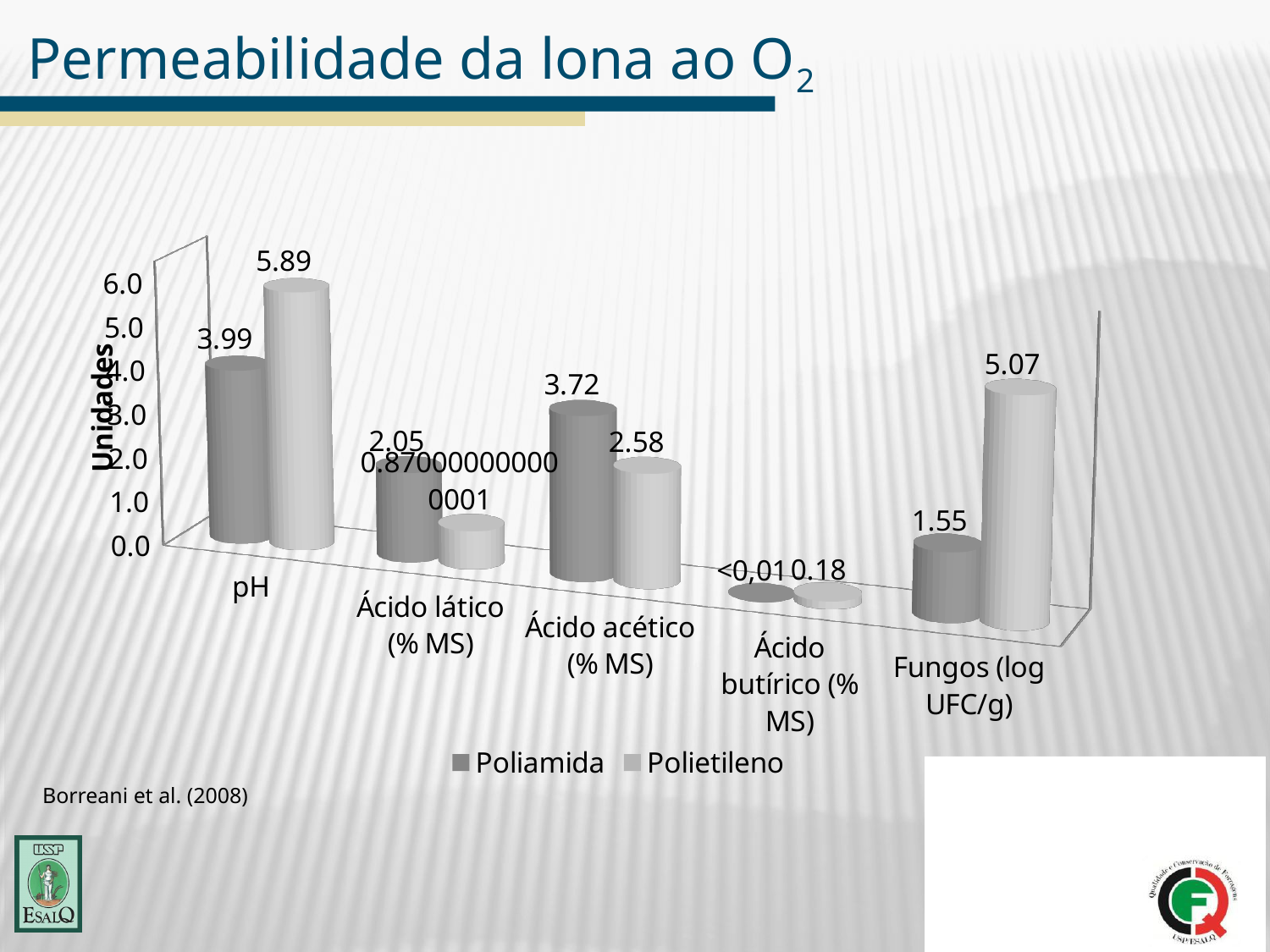
What is the Poliamida value for pH? 3.99 What is the Polietileno value for pH? 5.89 Is the Polietileno value for Ácido lático (% MS) greater or less than 2.0? less What kind of chart is shown on the slide? bar chart What is the difference between the Polietileno and Poliamida values for Fungos (log UFC/g)? 3.52 Which category has the highest Polietileno value? pH What is the Poliamida value for Ácido acético (% MS)? 3.72 Which category has the lowest Poliamida value? Ácido butírico (% MS) For Ácido acético (% MS), which series has the larger value, Poliamida or Polietileno? Poliamida What is the Polietileno value for Fungos (log UFC/g)? 5.07 How many series does the legend list? 2 What is the Poliamida value for Ácido lático (% MS)? 2.05